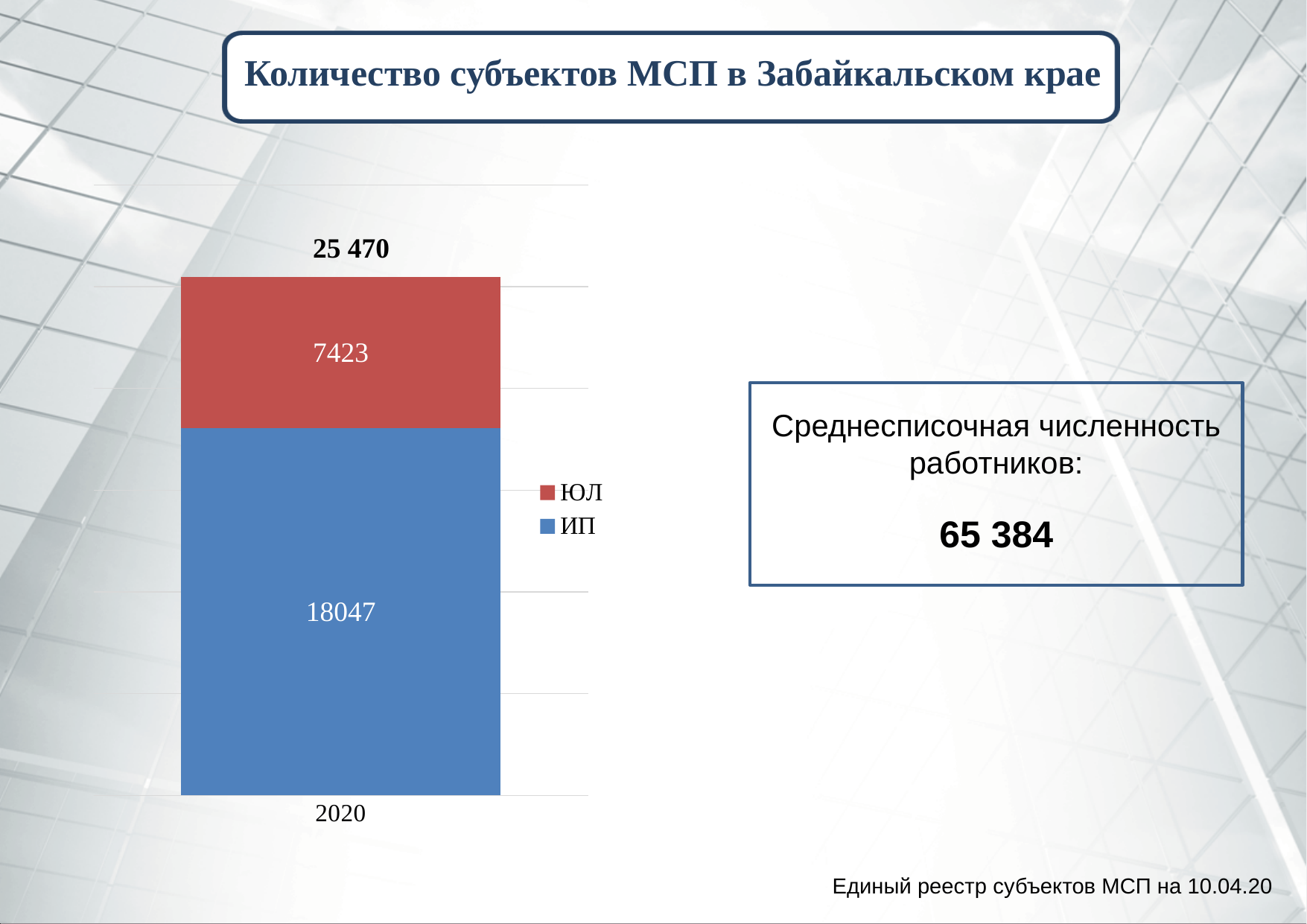
Which series is the largest in the 2020 bar? ИП Which colour represents ЮЛ in the chart? Red How many categories are shown on the x axis? 1 What is the value for ИП in 2020? 18047 What is the difference between the ИП and ЮЛ values in 2020? 10624 What is the value for ЮЛ in 2020? 7423 What is the total of the stacked bar for 2020? 25 470 Which category label appears on the x axis? 2020 How many series does the legend list? 2 What kind of chart is shown on the slide? Stacked bar chart Which series is the smallest in the 2020 bar? ЮЛ Which series has the larger value in 2020, ЮЛ or ИП? ИП